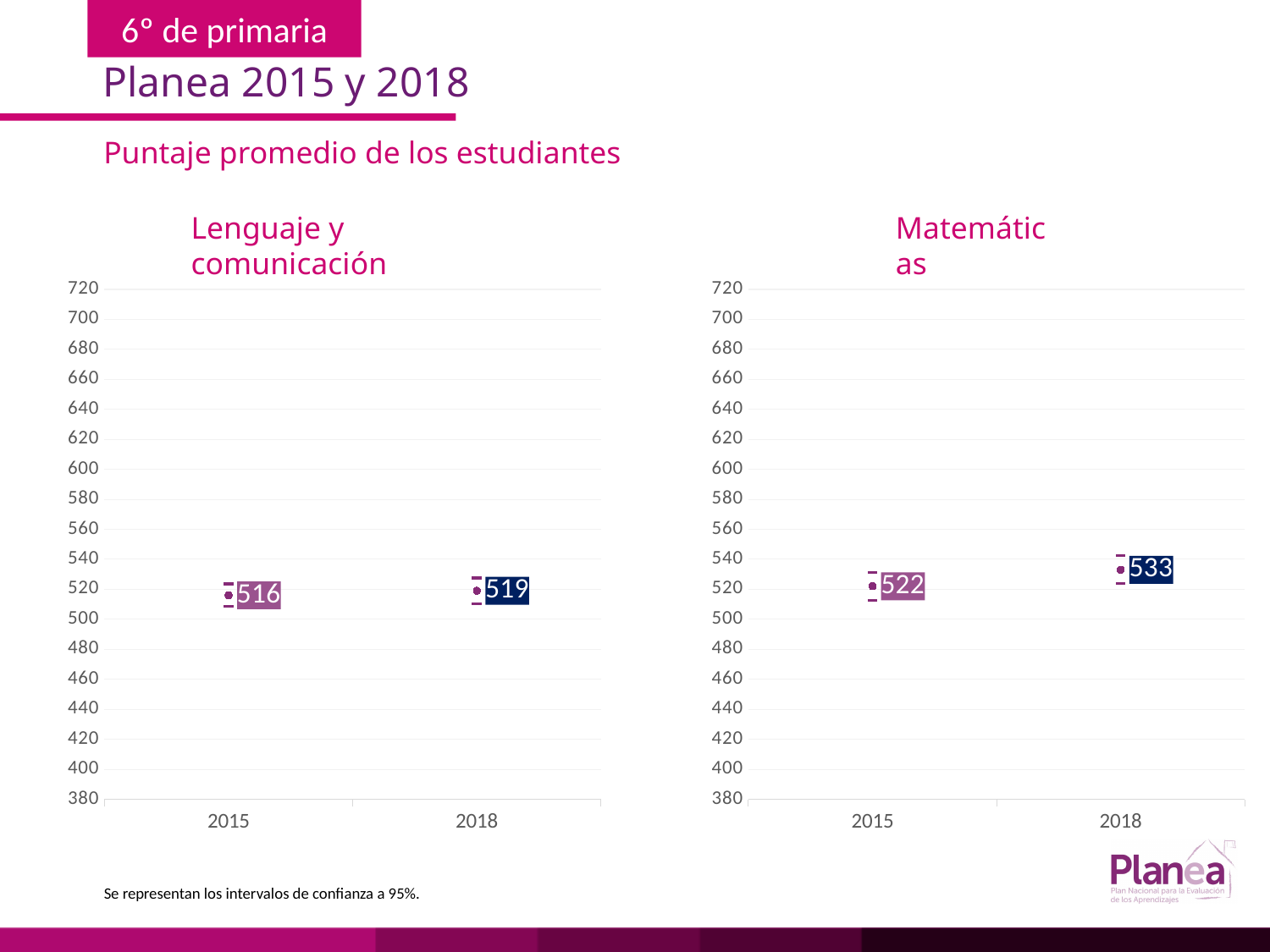
In the Matemáticas chart, what is the average score for 2018? 533 In the Matemáticas chart, which year has the higher average score? 2018 In the Lenguaje y comunicación chart, what is the average score for 2018? 519 In the Lenguaje y comunicación chart, what is the difference between the 2018 and 2015 scores? 3 In the Lenguaje y comunicación chart, what is the average score for 2015? 516 In the Lenguaje y comunicación chart, which year has the lower average score? 2015 In the Matemáticas chart, what is the average score for 2015? 522 How many years are plotted on the x axis of the Lenguaje y comunicación chart? 2 Which is larger: the 2018 score in the Lenguaje y comunicación chart or the 2018 score in the Matemáticas chart? Matemáticas 2018 In the Matemáticas chart, is the value for 2018 greater or less than 520? greater In the Matemáticas chart, do the scores rise or fall from 2015 to 2018? rise In the Matemáticas chart, by how many points did the average score change from 2015 to 2018? 11